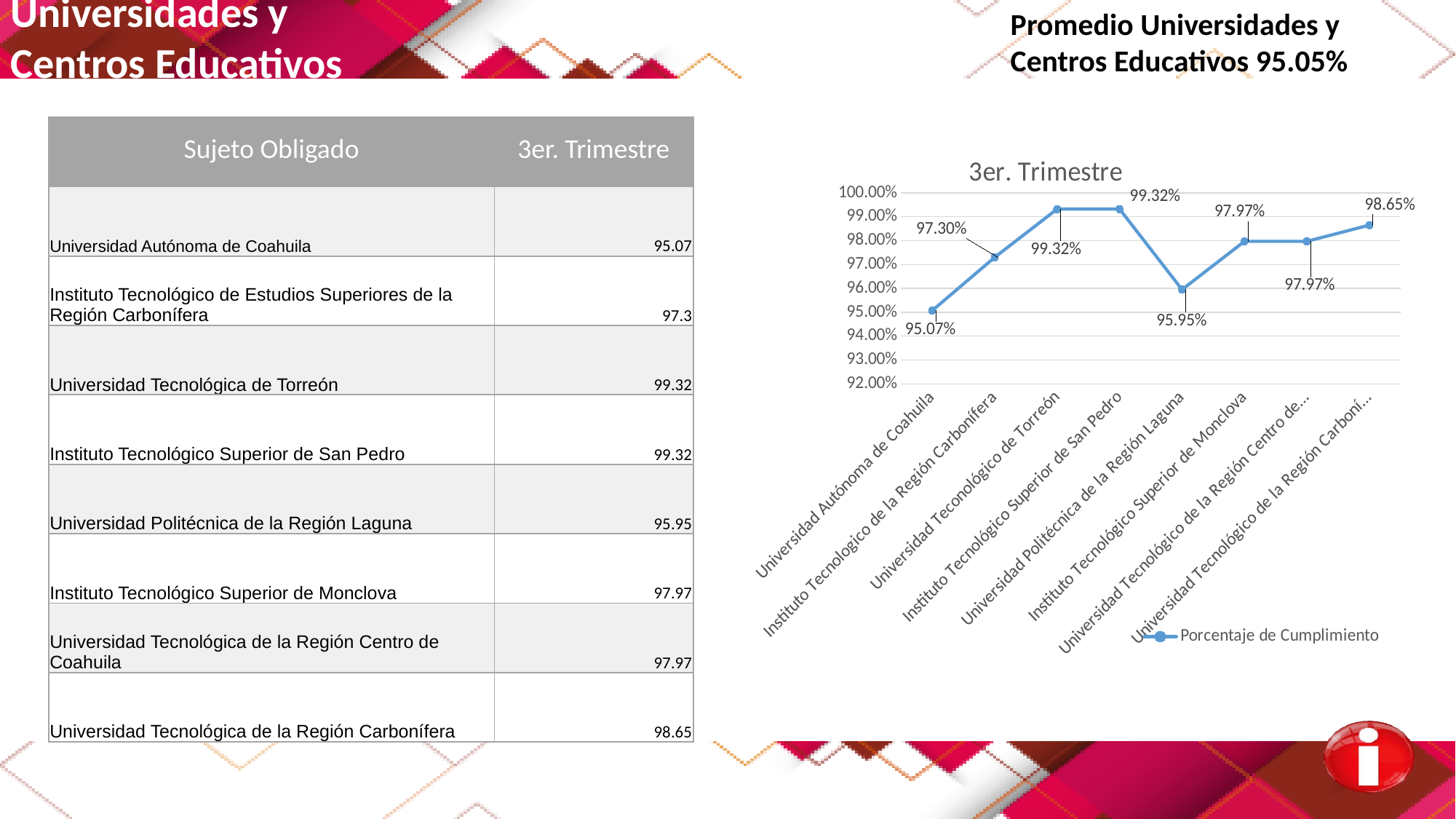
What is the value for Instituto Tecnológico Superior de Monclova in the chart? 97.97% How many data points are plotted in the chart? 8 Which category has the lowest value in the chart? Universidad Autónoma de Coahuila What is the title of the chart? 3er. Trimestre Which is larger: the value for Instituto Tecnológico Superior de Monclova or the value for Universidad Politécnica de la Región Laguna? Instituto Tecnológico Superior de Monclova What is the difference between the value for Instituto Tecnológico Superior de San Pedro and the value for Universidad Politécnica de la Región Laguna? 3.37% What series name does the chart legend show? Porcentaje de Cumplimiento What is the highest value plotted in the chart? 99.32% What is the value for Universidad Politécnica de la Región Laguna in the chart? 95.95% What is the value for Instituto Tecnológico de la Región Carbonífera in the chart? 97.30% What type of chart is shown on the slide? line chart What is the value for Universidad Autónoma de Coahuila in the chart? 95.07%